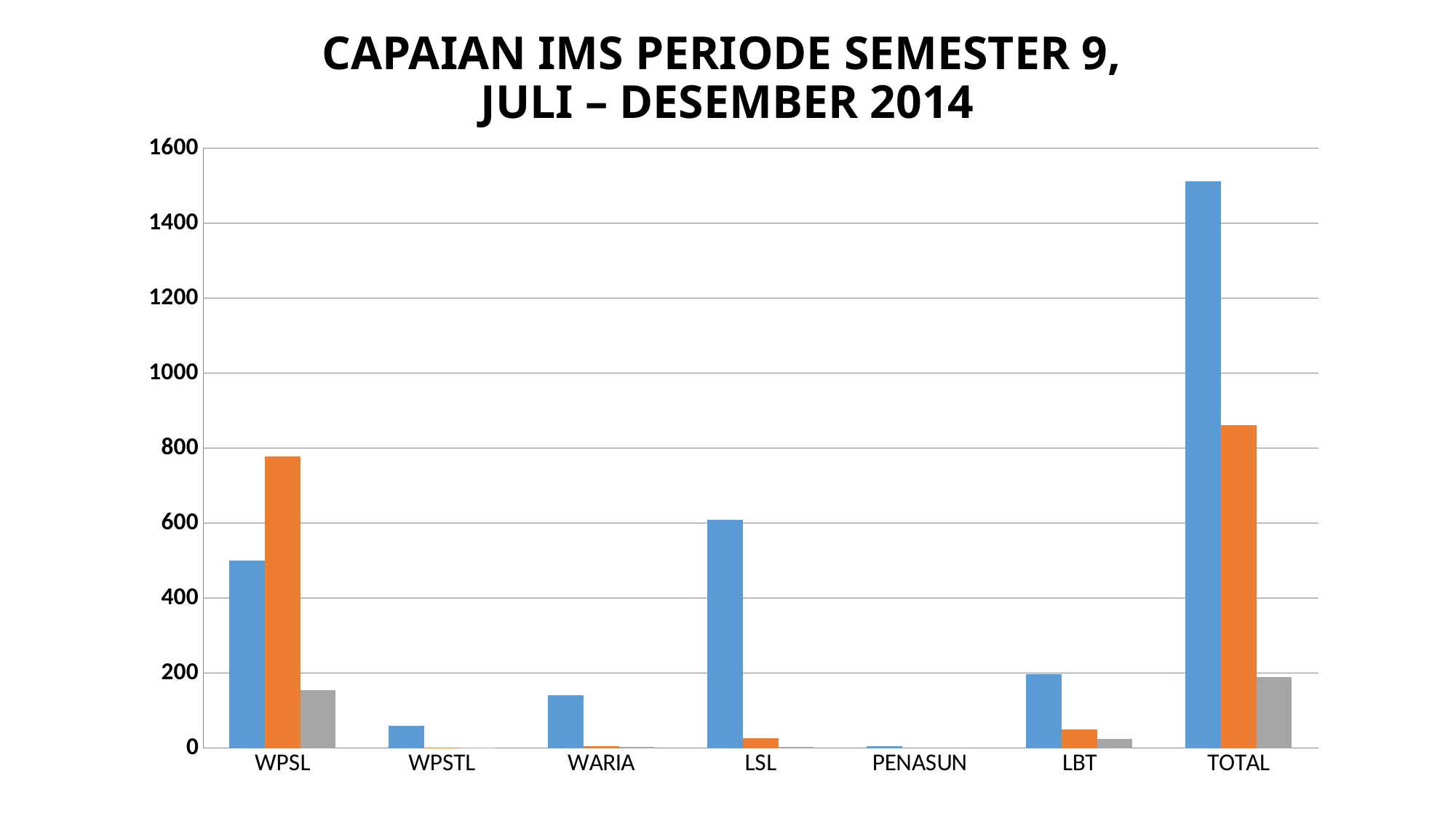
What kind of chart is shown on the slide? bar chart Is the blue bar for TOTAL greater or less than 1400? greater Is the orange bar for TOTAL greater or less than 800? greater For WPSL, which is larger: the blue bar or the orange bar? the orange bar What is the title of the chart? CAPAIAN IMS PERIODE SEMESTER 9, JULI – DESEMBER 2014 Which is larger: the blue bar for LSL or the blue bar for WPSL? LSL Which category has the tallest blue bar? TOTAL How many categories are shown on the x axis? 7 Is the blue bar for WARIA greater or less than 200? less How many differently coloured bar series are plotted in the chart? 3 Which category has the shortest blue bar? PENASUN Among the categories other than TOTAL, which has the tallest blue bar? LSL